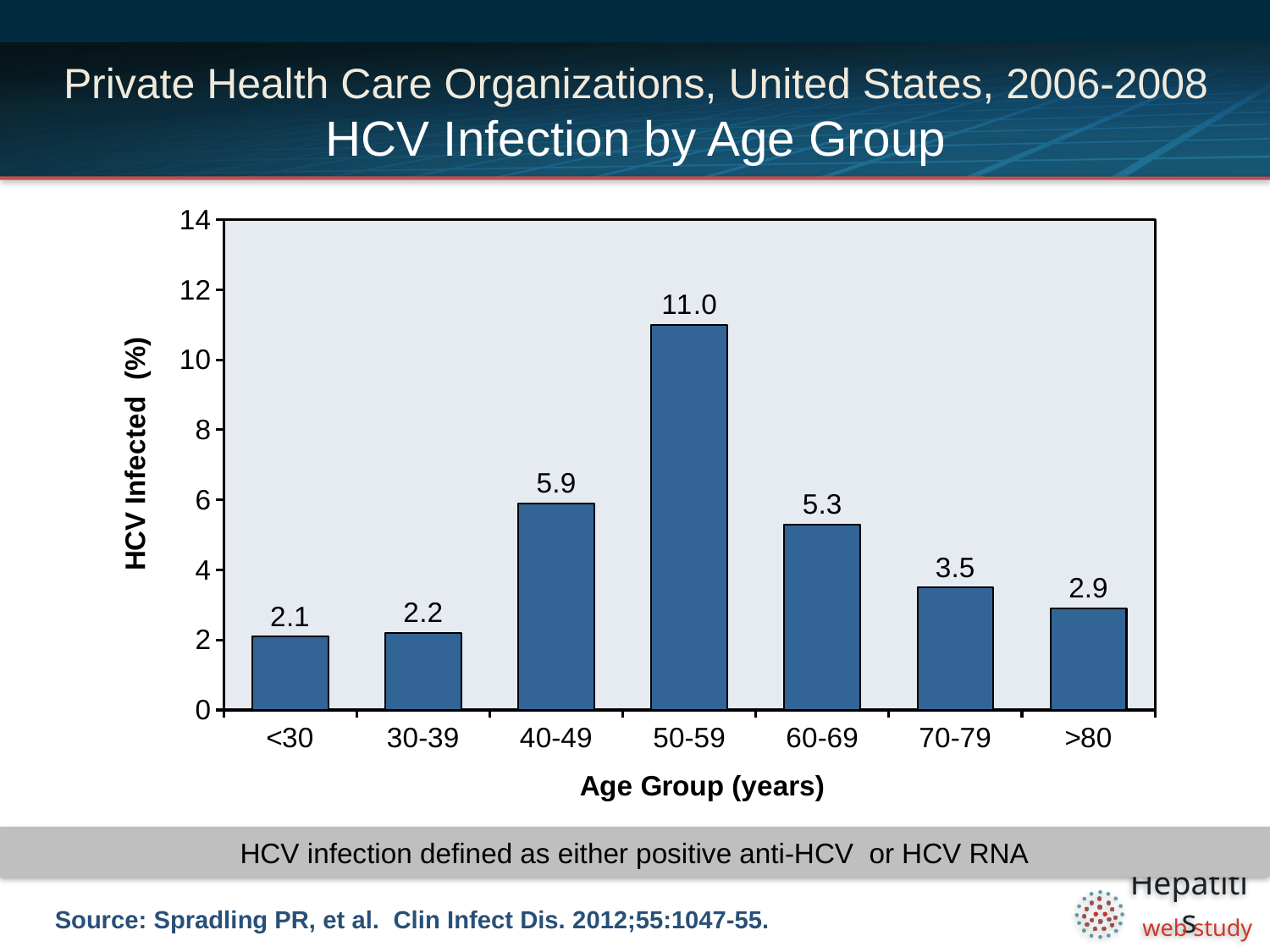
How many age groups are shown on the chart? 7 Do the values rise or fall from the 50-59 age group to the >80 age group? Fall What is the percentage of HCV infected for the <30 age group? 2.1 Which age group has the highest percentage of HCV infected? 50-59 What is the label of the y axis? HCV Infected (%) Is the value for the >80 age group greater or less than 4? less What is the percentage of HCV infected for the 70-79 age group? 3.5 What is the percentage of HCV infected for the 50-59 age group? 11.0 Which age group has the lowest percentage of HCV infected? <30 What is the difference in HCV infected percentage between the 50-59 and 40-49 age groups? 5.1 Which age group has a higher HCV infected percentage, 40-49 or 60-69? 40-49 What kind of chart is shown on the slide? Bar chart